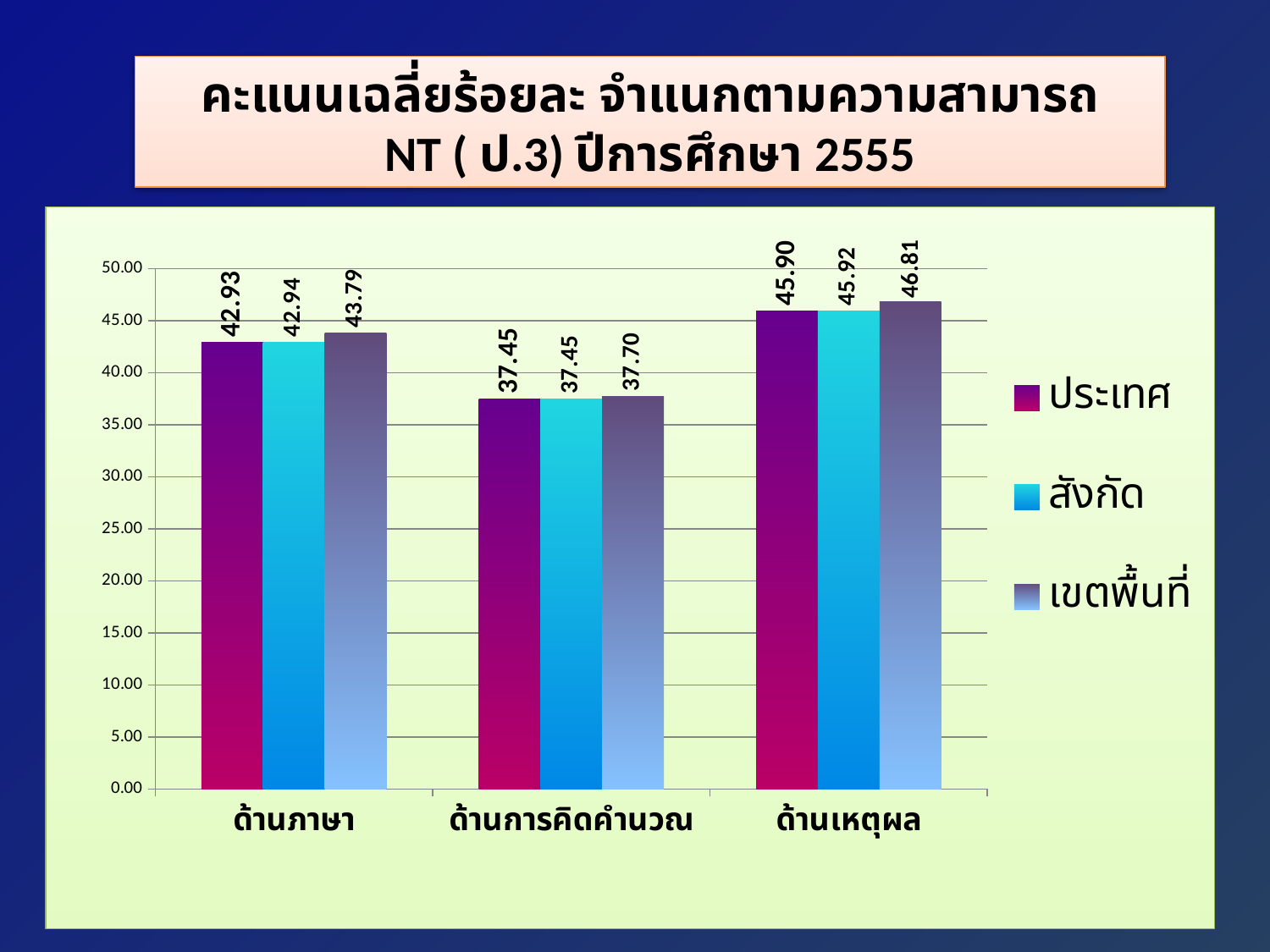
What is the value for เขตพื้นที่ in the ด้านเหตุผล category? 46.81 Is the value for สังกัด in the ด้านการคิดคำนวณ category greater or less than 40.00? less What is the value for สังกัด in the ด้านการคิดคำนวณ category? 37.45 What kind of chart is shown on the slide? bar chart Which category has the highest value for the เขตพื้นที่ series? ด้านเหตุผล What is the value for ประเทศ in the ด้านภาษา category? 42.93 What is the difference between the เขตพื้นที่ value and the ประเทศ value in the ด้านภาษา category? 0.86 Which category has the lowest value for the ประเทศ series? ด้านการคิดคำนวณ Which series is shown in cyan/blue in the legend? สังกัด How many series does the legend list? 3 Which is larger in the ด้านเหตุผล category: the value for ประเทศ or the value for เขตพื้นที่? เขตพื้นที่ How many categories are shown on the x axis? 3